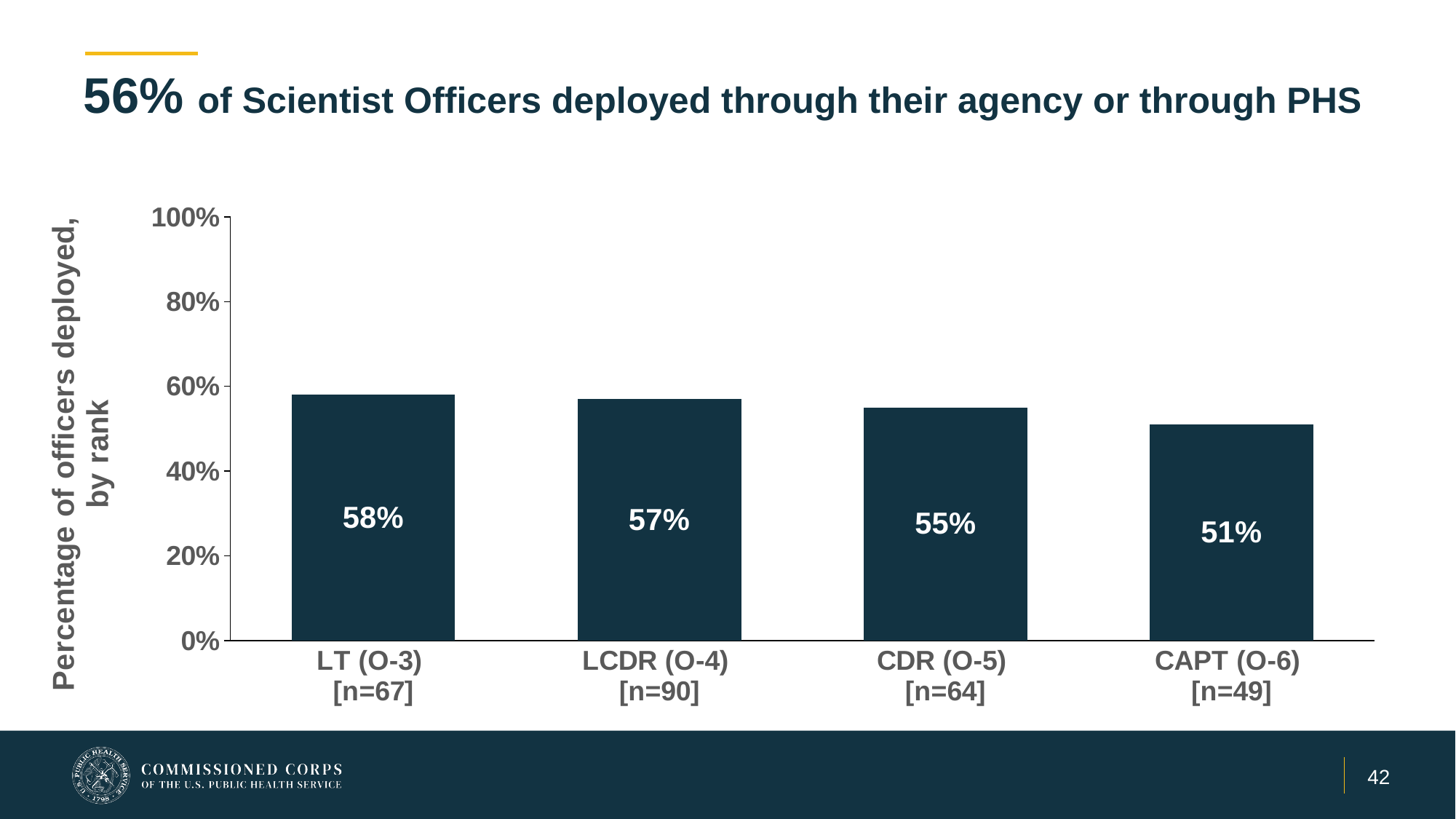
What percentage of CAPT (O-6) officers deployed? 51% What percentage of LT (O-3) officers deployed? 58% Which rank has the highest percentage of officers deployed? LT (O-3) What kind of chart is shown on the slide? bar chart Is the value for CAPT (O-6) greater or less than 60%? less Which has a higher percentage deployed, CDR (O-5) or CAPT (O-6)? CDR (O-5) Do the values rise or fall from LT (O-3) to CAPT (O-6)? fall Which rank has the lowest percentage of officers deployed? CAPT (O-6) What percentage of LCDR (O-4) officers deployed? 57% What percentage of CDR (O-5) officers deployed? 55% How many rank categories are shown in the chart? 4 What is the difference in percentage points between LT (O-3) and CAPT (O-6)? 7